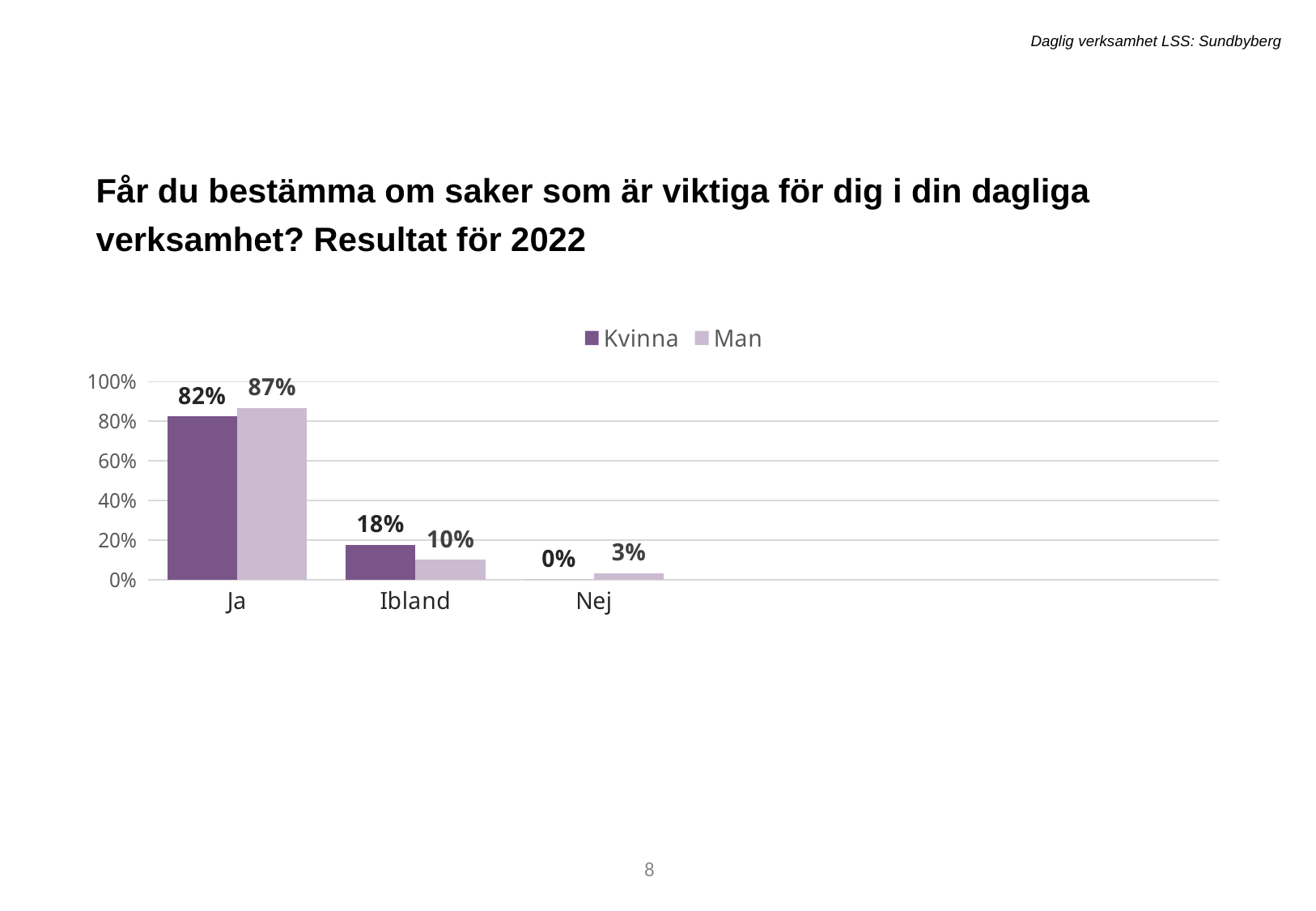
How many categories are shown on the x axis? 3 Do the values for the Man series rise or fall from Ja to Nej along the x axis? Fall In the Ibland category, which series has the larger value, Kvinna or Man? Kvinna How many series does the legend list? 2 What is the difference between the Man and Kvinna values in the Ja category? 5% Which category has the highest value for the Man series? Ja What is the value for Kvinna in the Ibland category? 18% What kind of chart is shown on the slide? Bar chart What is the value for Kvinna in the Ja category? 82% What is the value for Man in the Ja category? 87% What is the value for Man in the Nej category? 3% Which category has the lowest value for the Kvinna series? Nej